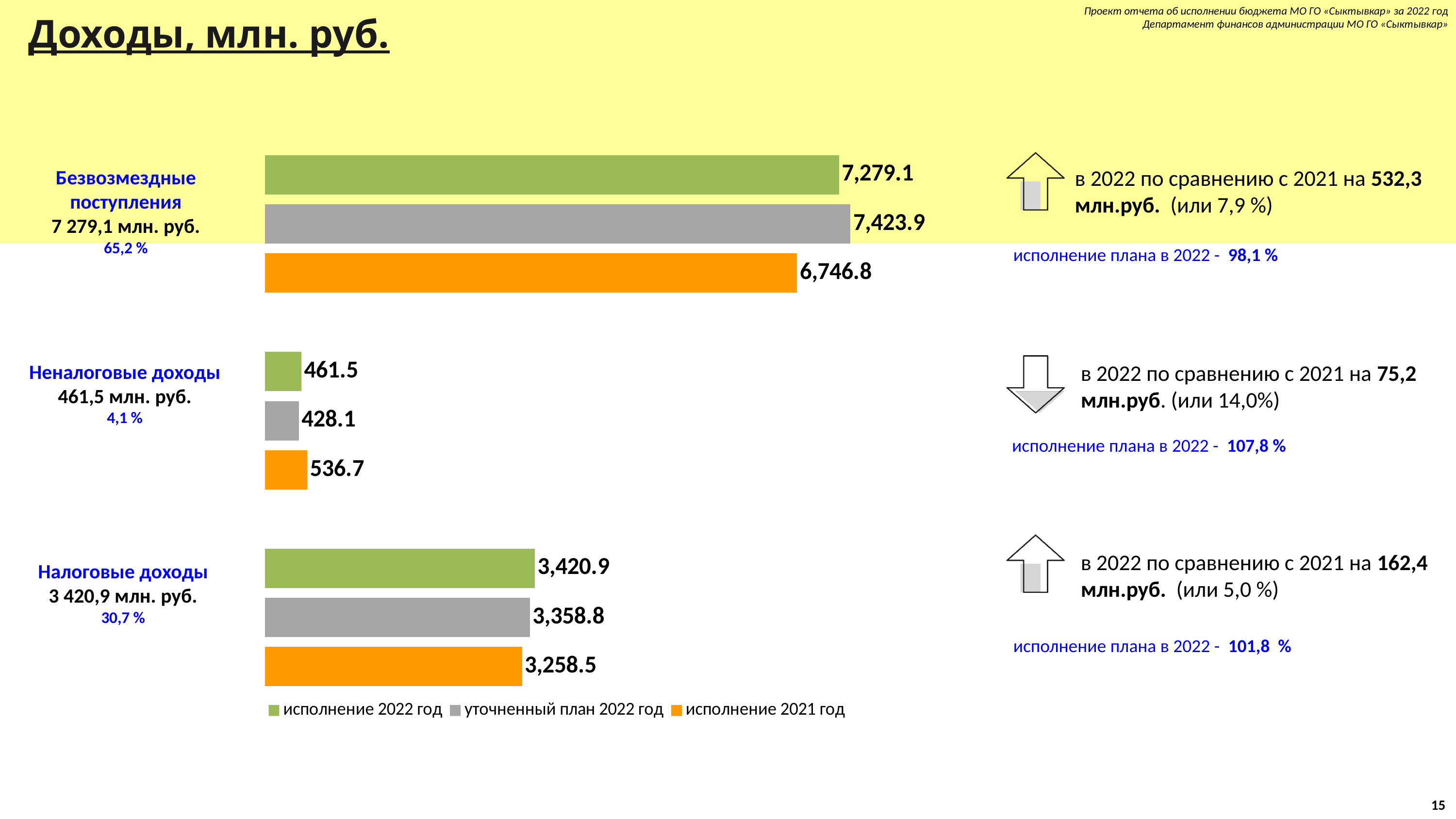
What is the difference between 'исполнение 2022 год' and 'исполнение 2021 год' for 'Налоговые доходы'? 162.4 Which category has the lowest value for 'исполнение 2021 год'? Неналоговые доходы Which category has the highest value for 'исполнение 2022 год'? Безвозмездные поступления For 'Неналоговые доходы', which is larger: 'исполнение 2022 год' or 'исполнение 2021 год'? исполнение 2021 год Which colour represents 'исполнение 2021 год' in the chart legend? orange What type of chart is shown on the slide? bar chart How many series does the chart legend list? 3 What is the value of 'исполнение 2021 год' for 'Налоговые доходы'? 3,258.5 What is the difference between 'уточненный план 2022 год' and 'исполнение 2022 год' for 'Безвозмездные поступления'? 144.8 What is the value of 'уточненный план 2022 год' for 'Неналоговые доходы'? 428.1 What is the value of 'исполнение 2022 год' for 'Безвозмездные поступления'? 7,279.1 How many categories are shown in the chart? 3